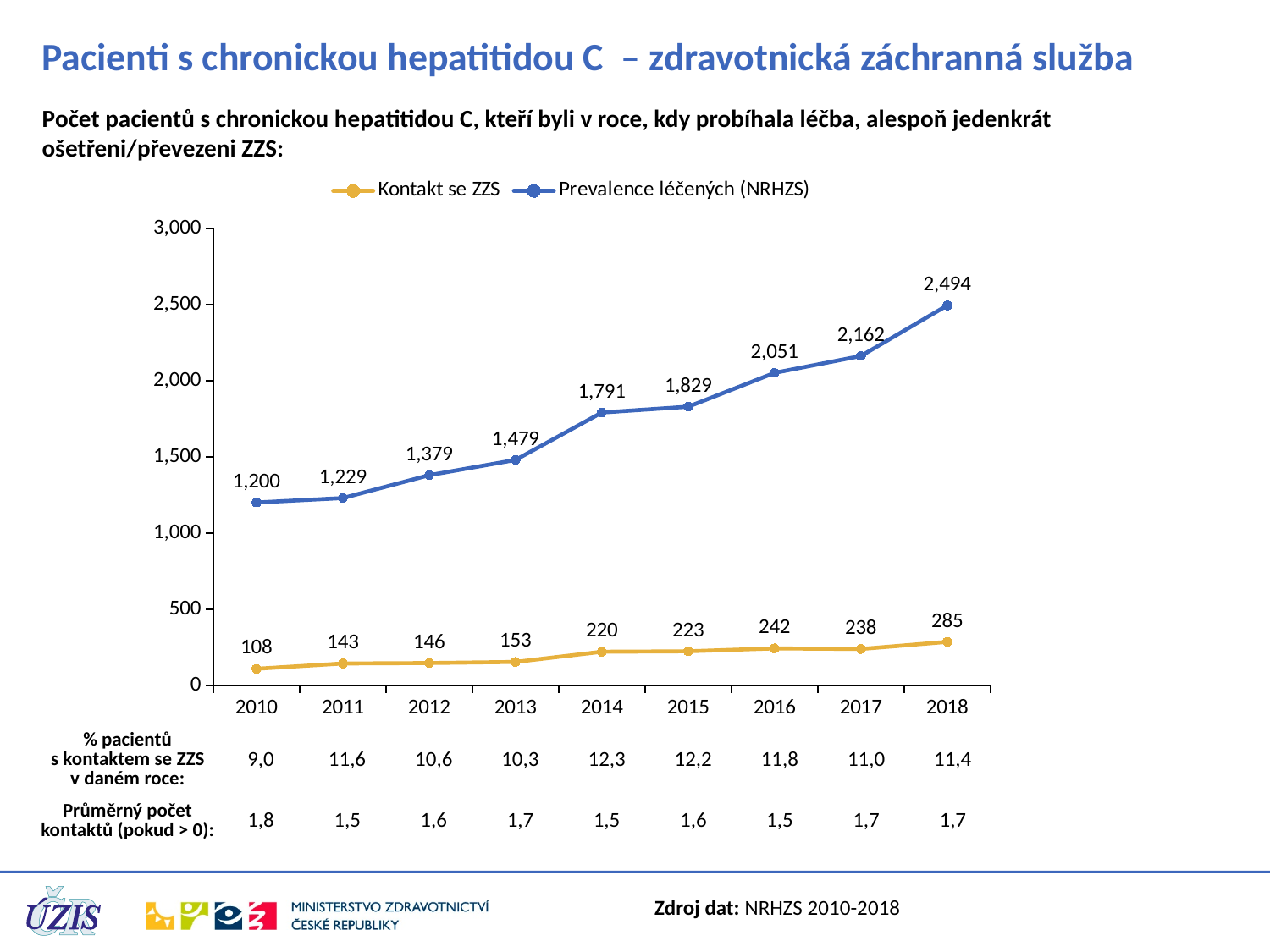
Is the value of Prevalence léčených (NRHZS) in 2013 greater or less than 1,500? less What is the difference between Kontakt se ZZS in 2016 and in 2017? 4 In which year is Kontakt se ZZS lowest? 2010 How many series does the legend list? 2 What is the difference between Prevalence léčených (NRHZS) in 2018 and in 2017? 332 In which year is Prevalence léčených (NRHZS) highest? 2018 Does Prevalence léčených (NRHZS) rise or fall from 2010 to 2018? rise What is the value of Prevalence léčených (NRHZS) in 2016? 2,051 What is the value of Kontakt se ZZS in 2014? 220 What kind of chart is shown? line chart Which is larger: Kontakt se ZZS in 2015 or in 2016? 2016 How many years are shown on the x axis? 9